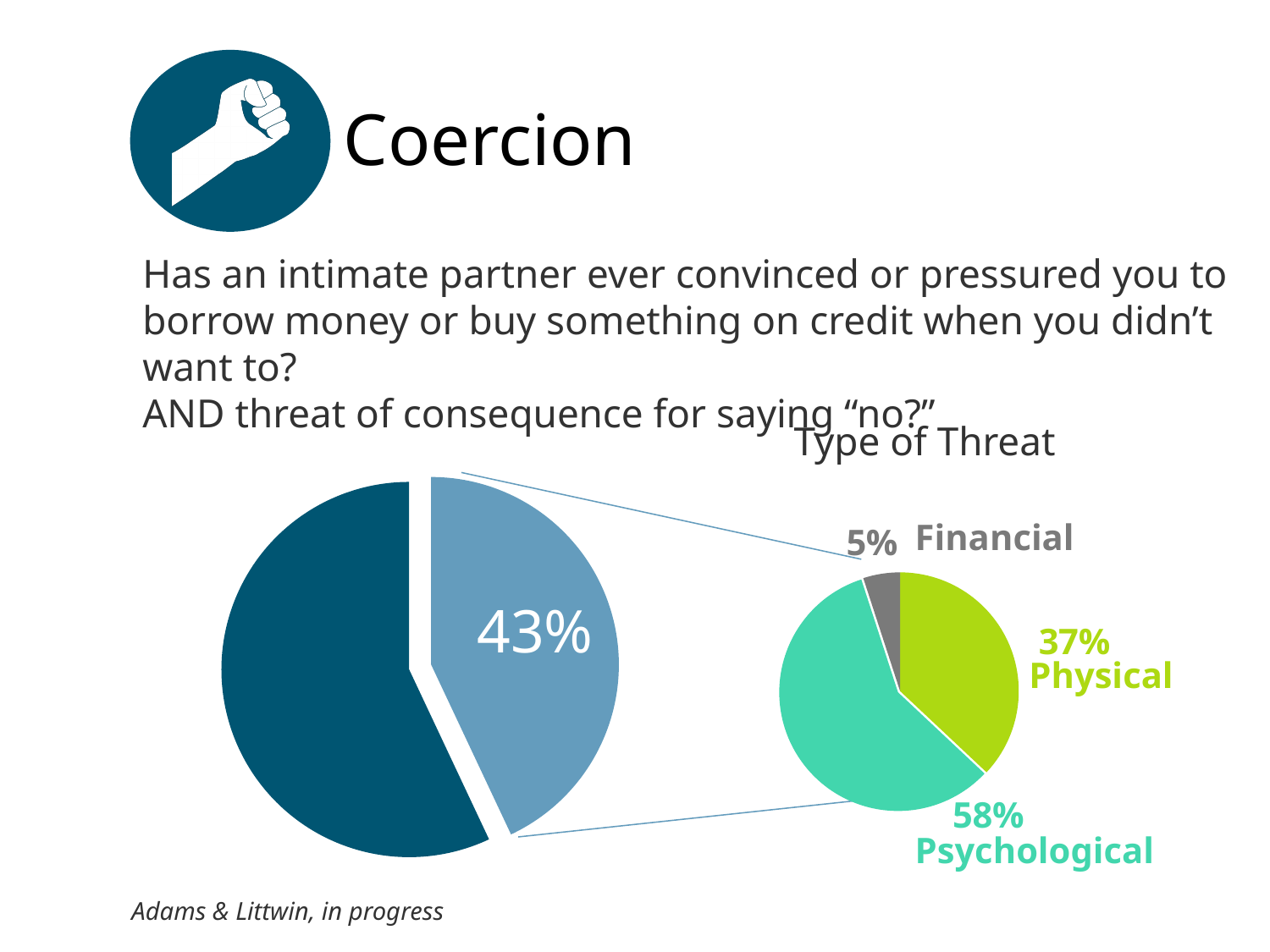
In the "Type of Threat" chart, what share is Psychological? 58% In the "Type of Threat" chart, what share is Physical? 37% How many slices does the large pie chart on the left of the slide have? 2 In the "Type of Threat" chart, what share is Financial? 5% In the "Type of Threat" chart, which is larger, Physical or Financial? Physical What kind of chart is the "Type of Threat" chart on the right of the slide? pie chart In the large pie chart on the left of the slide, what percentage is printed on the labeled slice? 43% What is the title of the smaller pie chart on the right of the slide? Type of Threat How many categories does the "Type of Threat" pie chart show? 3 In the "Type of Threat" chart, which type of threat has the smallest share? Financial In the "Type of Threat" chart, how many percentage points larger is Psychological than Physical? 21% In the "Type of Threat" chart, which type of threat has the largest share? Psychological